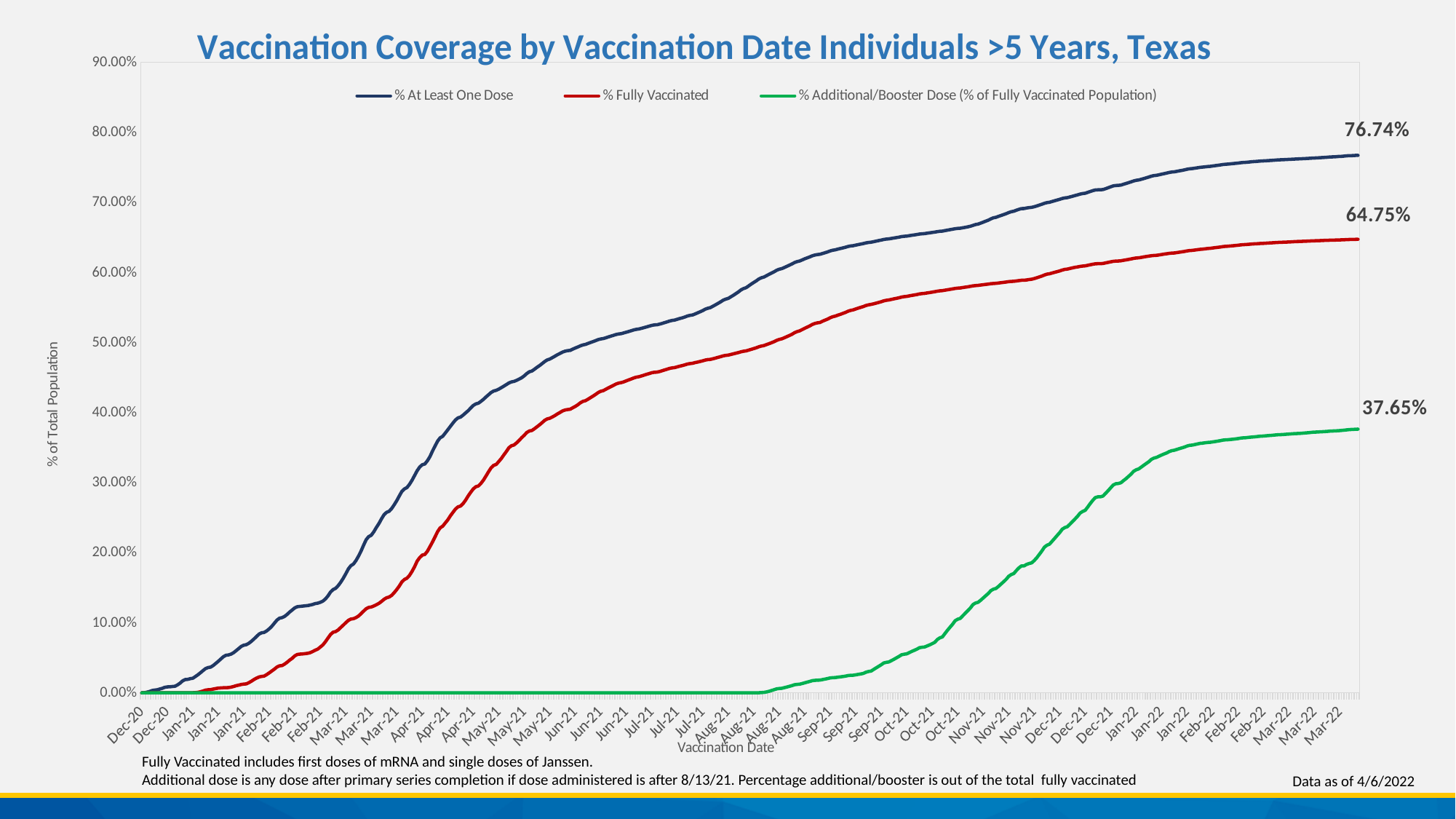
Which series has the lowest value at the end of the chart? % Additional/Booster Dose (% of Fully Vaccinated Population) Do the values for % At Least One Dose rise or fall over time along the x axis? Rise What is the final labelled value for % Additional/Booster Dose (% of Fully Vaccinated Population)? 37.65% What type of chart is shown on the slide? Line chart How many series does the legend list? 3 What is the title of the chart? Vaccination Coverage by Vaccination Date Individuals >5 Years, Texas Which series has the highest value at the end of the chart? % At Least One Dose What is the final labelled value for % Fully Vaccinated? 64.75% What is the final labelled value for % At Least One Dose? 76.74% What is the difference between the final labelled values for % At Least One Dose and % Fully Vaccinated? 11.99% Is the value for % Fully Vaccinated in Jul-21 greater or less than 40%? greater Which is larger at the end of the chart: % Fully Vaccinated or % Additional/Booster Dose? % Fully Vaccinated